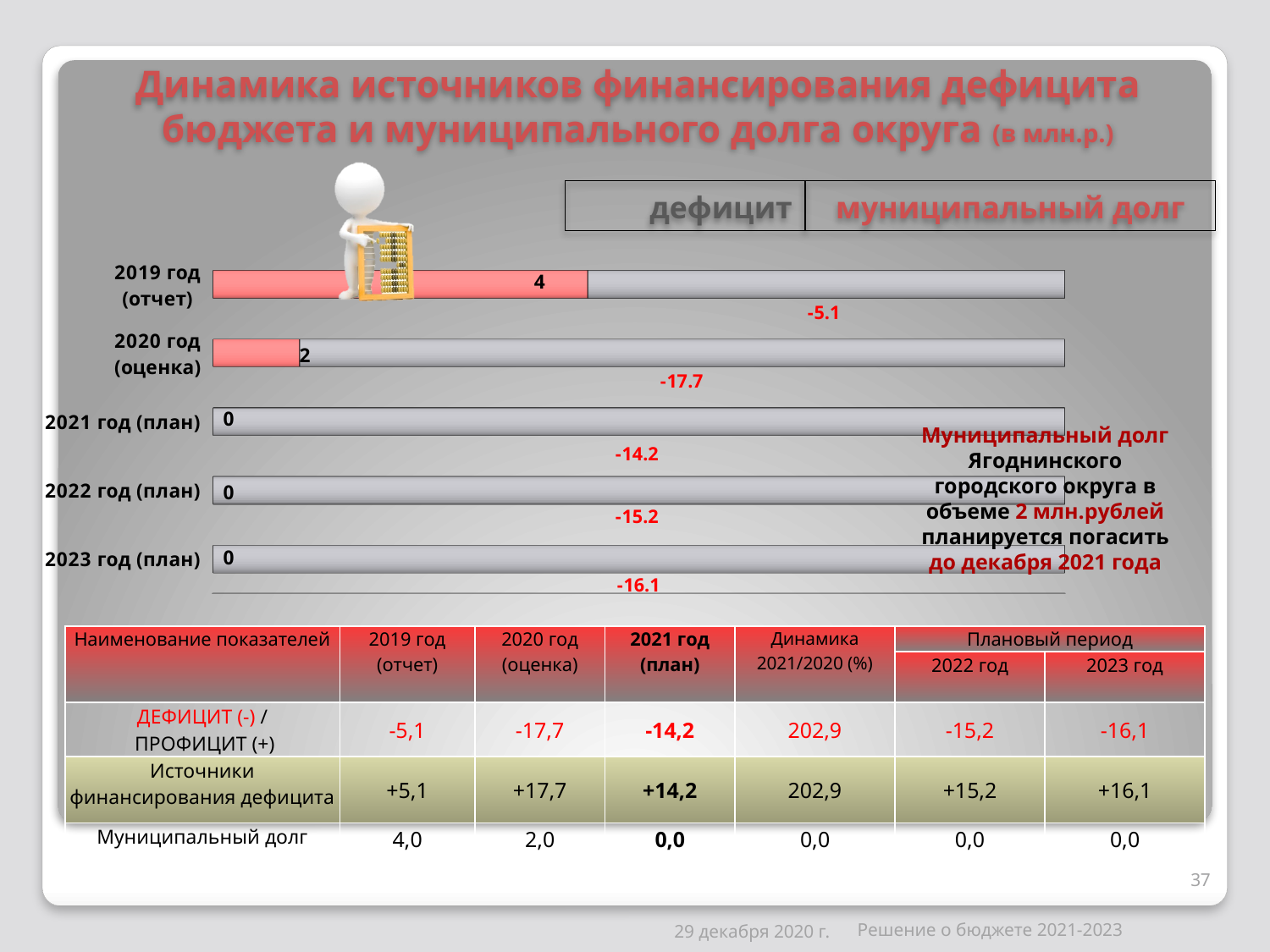
What is the value of дефицит for 2020 год (оценка)? -17.7 What is the difference between the муниципальный долг values for 2019 год (отчет) and 2020 год (оценка)? 2 How many series does the chart legend list? 2 What is the value of муниципальный долг for 2019 год (отчет)? 4 What is the value of дефицит for 2023 год (план)? -16.1 How many year categories are plotted in the chart? 5 What kind of chart is shown on the slide? bar chart Does муниципальный долг rise or fall from 2019 to 2023? fall Which year has the highest value of муниципальный долг? 2019 год (отчет) What is the value of муниципальный долг for 2020 год (оценка)? 2 What are the two entries in the chart legend? дефицит, муниципальный долг Which year has the lowest (most negative) value of дефицит? 2020 год (оценка)